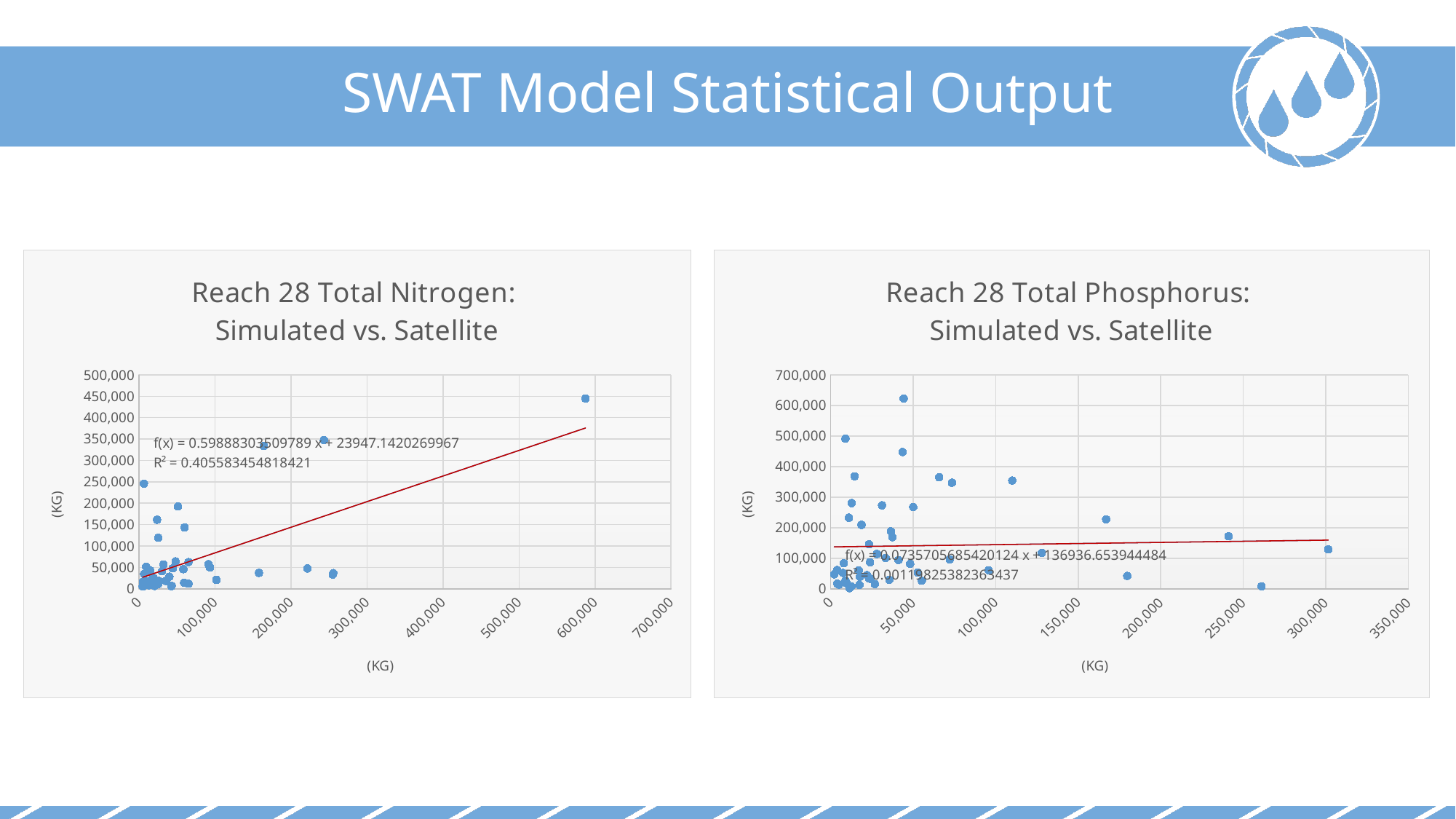
In the 'Reach 28 Total Nitrogen' chart, what is the trendline equation shown? f(x) = 0.59888303509789 x + 23947.1420269967 Which chart has the larger R² value, the Total Nitrogen chart or the Total Phosphorus chart? Total Nitrogen What unit label is shown on the axes of both charts? (KG) In the 'Reach 28 Total Nitrogen' chart, is the y value of the highest point greater or less than 400,000? greater In the 'Reach 28 Total Phosphorus' chart, is the y value of the highest point greater or less than 500,000? greater In the 'Reach 28 Total Nitrogen' chart, what is the R² value shown for the trendline? 0.405583454818421 What kind of chart is the 'Reach 28 Total Phosphorus: Simulated vs. Satellite' chart? scatter chart In the 'Reach 28 Total Phosphorus' chart, what is the R² value shown for the trendline? 0.00119825382363437 In the 'Reach 28 Total Phosphorus' chart, what is the trendline equation shown? f(x) = 0.0735705685420124 x + 136936.653944484 What kind of chart is the 'Reach 28 Total Nitrogen: Simulated vs. Satellite' chart? scatter chart In the 'Reach 28 Total Nitrogen' chart, does the trendline rise or fall as x increases? rise What is the maximum value shown on the x axis of the 'Reach 28 Total Phosphorus' chart? 350,000